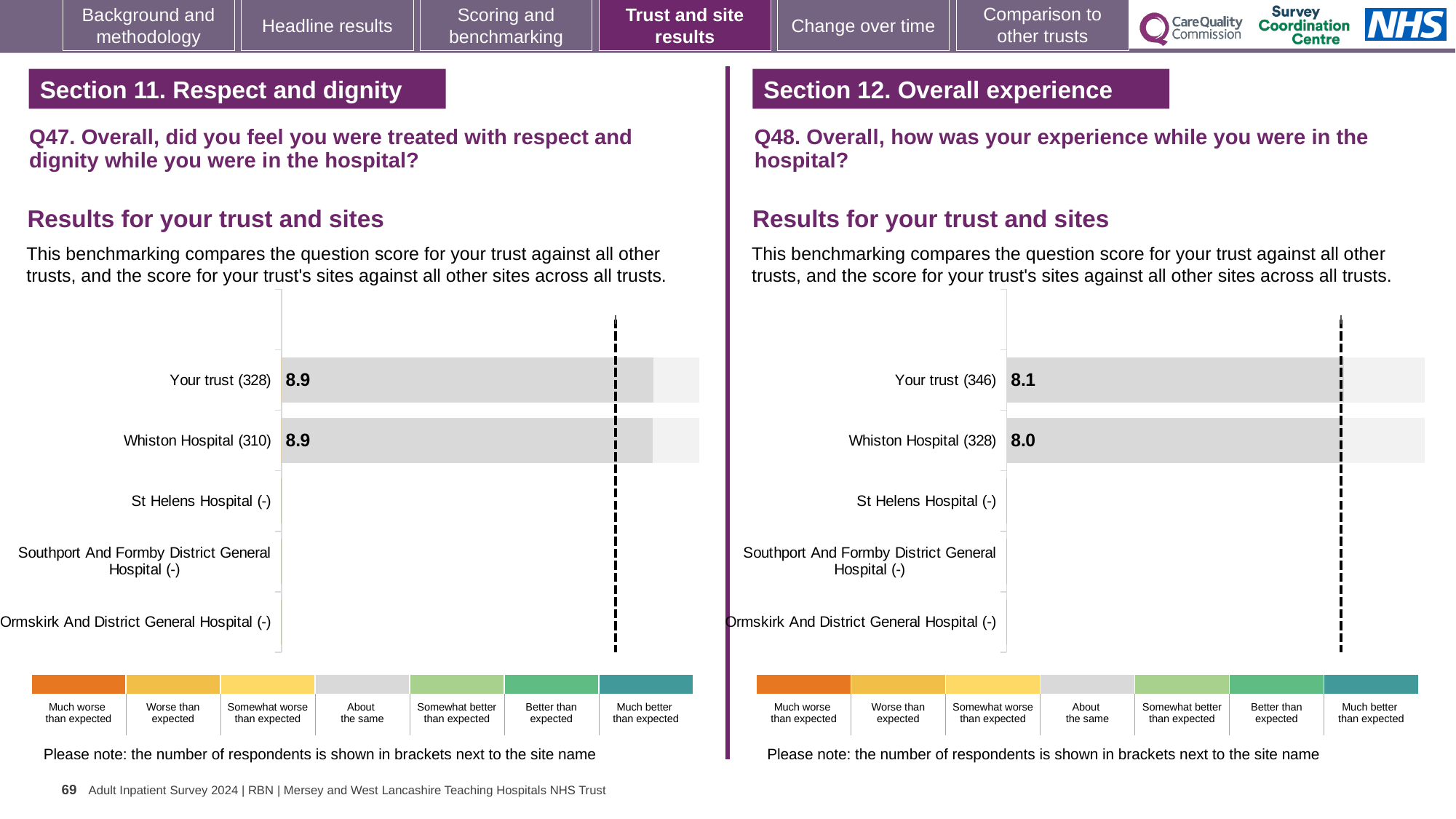
On the Q47 chart (left), what is the score for Whiston Hospital? 8.9 What type of chart is used on the Q48 chart (right)? Bar chart On the Q48 chart (right), how many respondents are shown in brackets for Your trust? 346 On the Q47 chart (left), how many respondents are shown in brackets for Whiston Hospital? 310 On the Q48 chart (right), what is the score for Your trust? 8.1 On the Q47 chart (left), what is the difference between the score for Your trust and the score for Whiston Hospital? 0 On the Q47 chart (left), what is the score for Your trust? 8.9 On the Q48 chart (right), what is the difference between the score for Your trust and the score for Whiston Hospital? 0.1 On the Q48 chart (right), what is the score for Whiston Hospital? 8.0 On the Q48 chart (right), which has the higher score, Your trust or Whiston Hospital? Your trust How many site/trust categories are listed on the Q47 chart (left)? 5 On the Q47 chart (left), which sites have no score shown (marked with a dash)? St Helens Hospital, Southport And Formby District General Hospital, Ormskirk And District General Hospital